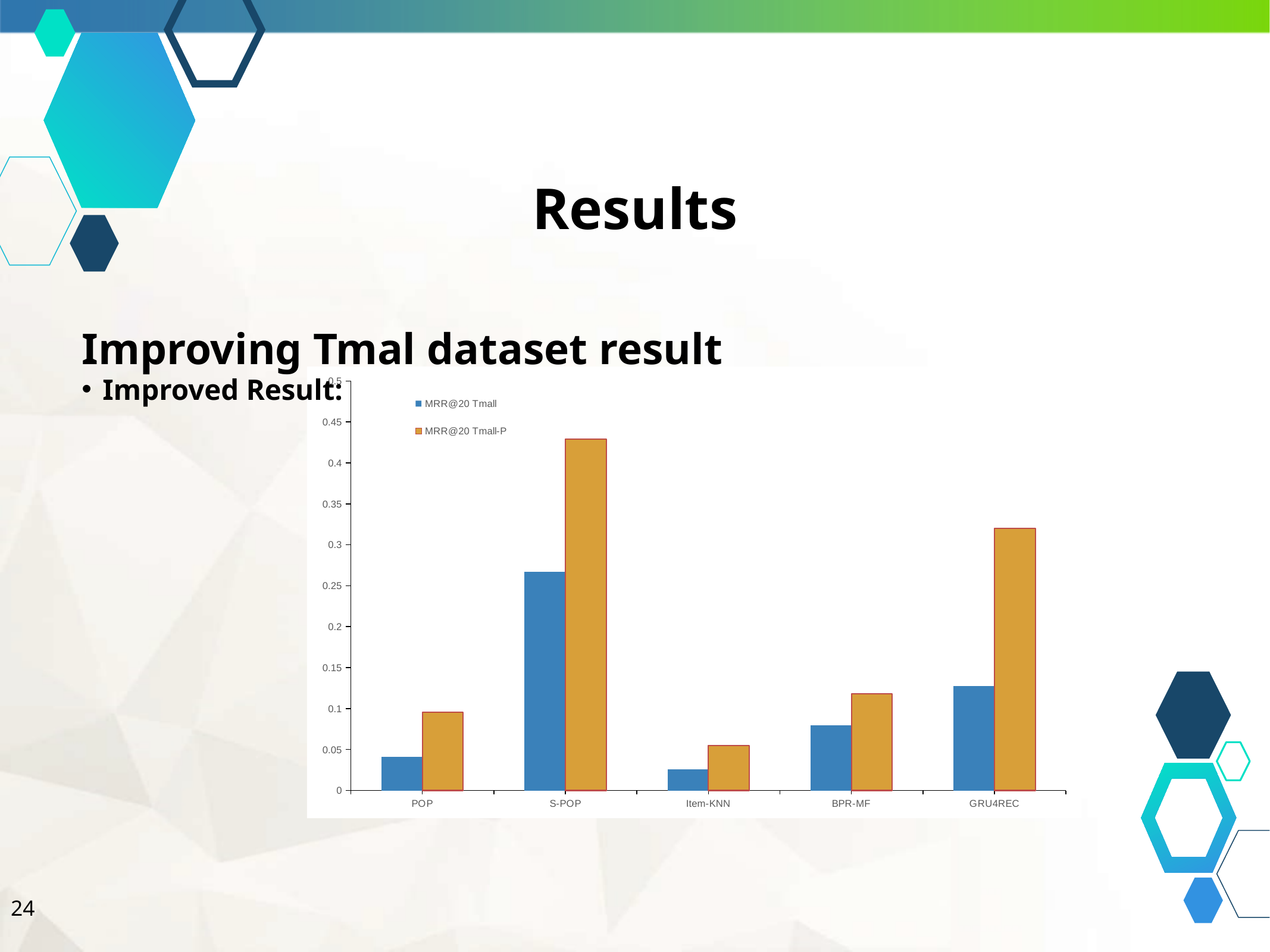
Which category has the highest MRR@20 Tmall-P value? S-POP Is the MRR@20 Tmall-P value for GRU4REC greater or less than 0.3? greater Which is larger: the MRR@20 Tmall-P value for GRU4REC or for BPR-MF? GRU4REC How many series does the chart's legend list? 2 Which category has the lowest MRR@20 Tmall value? Item-KNN Is the MRR@20 Tmall-P value for S-POP greater or less than 0.4? greater What are the two series names listed in the chart's legend? MRR@20 Tmall and MRR@20 Tmall-P What kind of chart is shown on the slide? bar chart Which is larger: the MRR@20 Tmall value for POP or for Item-KNN? POP Is the MRR@20 Tmall value for Item-KNN greater or less than 0.05? less How many categories (methods) are shown on the x axis of the chart? 5